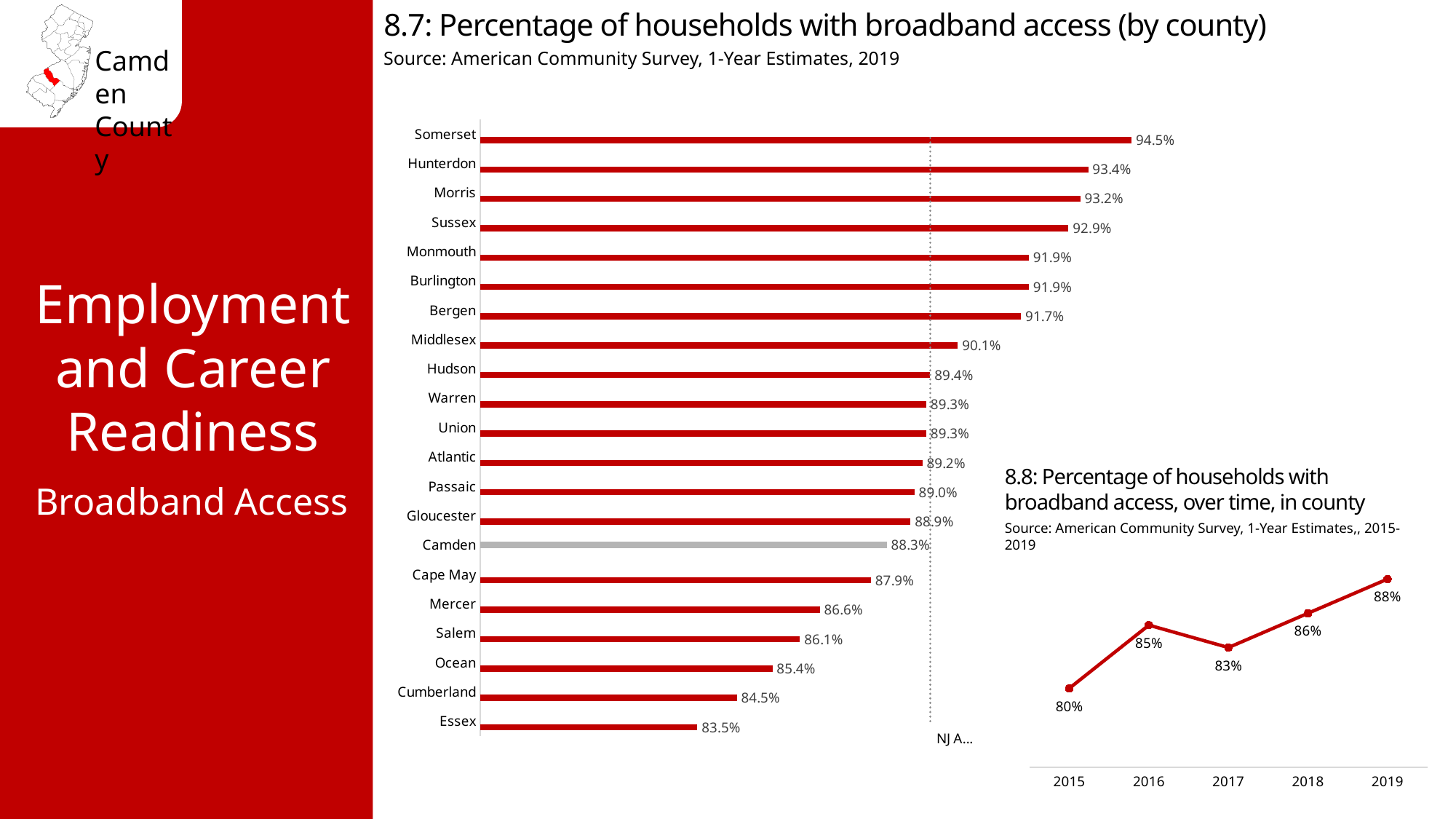
In chart 8.7 (by county), what is the value for Somerset? 94.5% In chart 8.8 (broadband access over time in county), how many data points are plotted? 5 In chart 8.8 (broadband access over time in county), what is the value for 2017? 83% In chart 8.7 (by county), which has a higher value, Mercer or Cape May? Cape May In chart 8.7 (by county), which county has the highest percentage of households with broadband access? Somerset In chart 8.7 (by county), what is the difference between Somerset and Essex? 11.0% In chart 8.7 (Percentage of households with broadband access by county), what is the value for Camden? 88.3% In chart 8.7 (by county), how many counties are shown? 21 In chart 8.8 (broadband access over time in county), which year has the highest value? 2019 What kind of chart is chart 8.7 (Percentage of households with broadband access by county)? Bar chart In chart 8.8 (broadband access over time in county), what is the difference between 2019 and 2015? 8% In chart 8.7 (by county), which county has the lowest percentage of households with broadband access? Essex